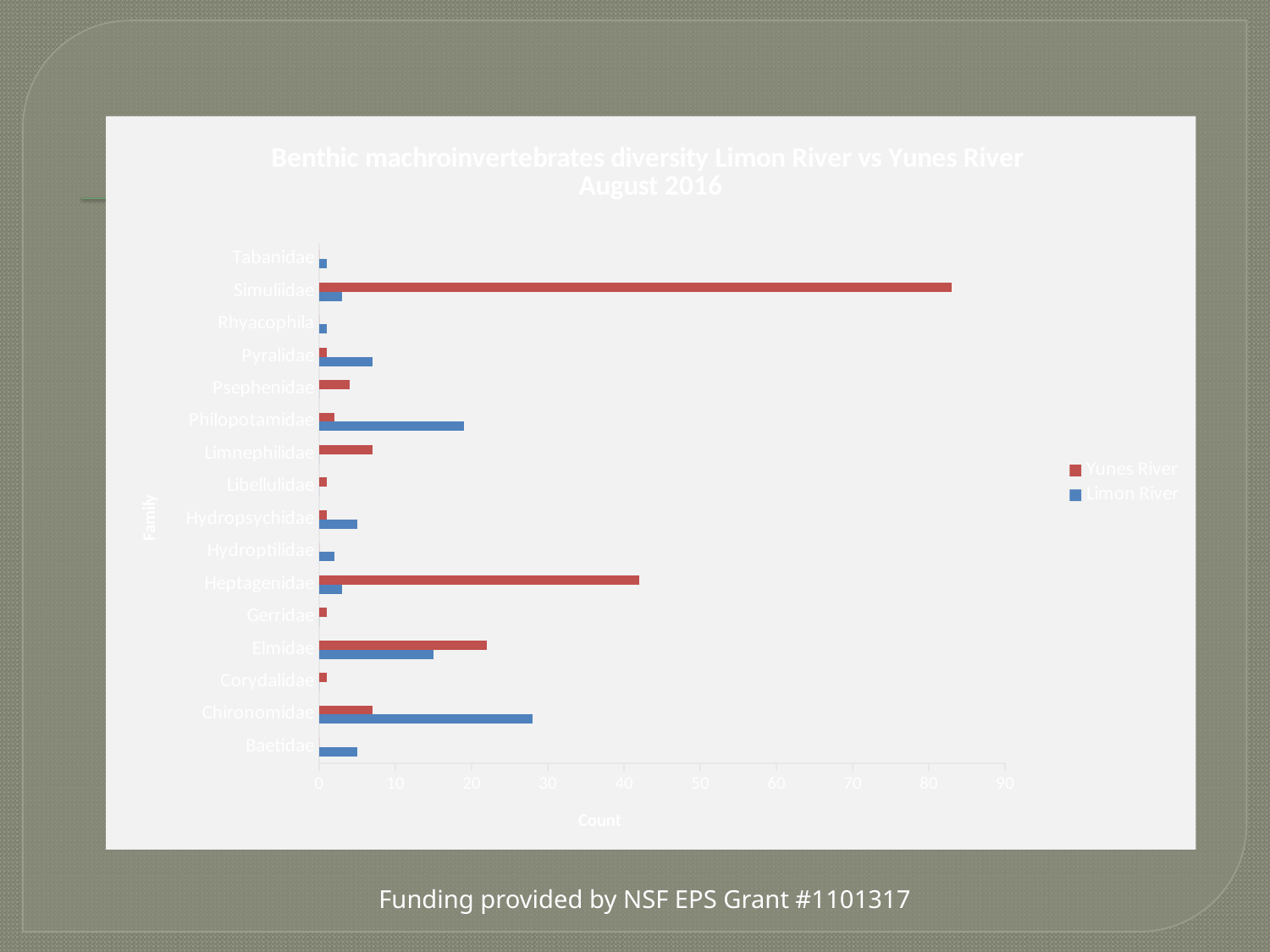
Which family has the highest Yunes River count? Simuliidae For Elmidae, which river has the larger count, Yunes River or Limon River? Yunes River How many families are listed on the vertical axis of the chart? 16 What is the label of the horizontal axis of the chart? Count Is the Limon River value for Elmidae greater or less than 10? greater How many series does the legend list? 2 For Chironomidae, which river has the larger count, Yunes River or Limon River? Limon River Is the Yunes River value for Heptagenidae greater or less than 40? greater Is the Limon River value for Chironomidae greater or less than 30? less Which family has the highest Limon River count? Chironomidae What kind of chart is shown on the slide? bar chart